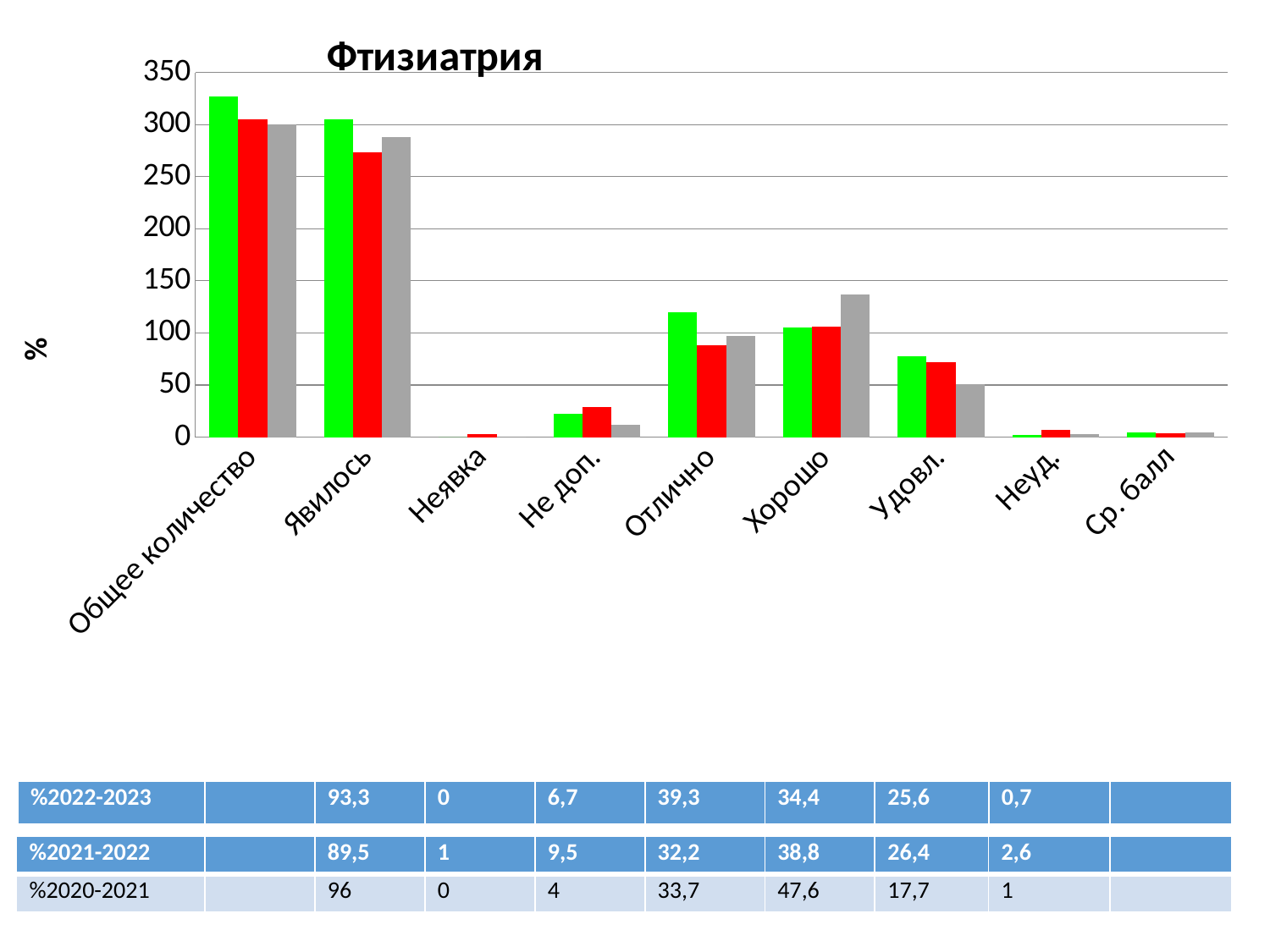
What kind of chart is shown on the slide? bar chart How many categories are shown on the x axis of the chart? 9 What label is shown on the vertical axis of the chart? % For the category Хорошо, which bar is taller: the gray bar or the green bar? the gray bar For the category Отлично, which bar is taller: the green bar or the gray bar? the green bar Is the value of the red bar for Отлично greater or less than 100? less Is the value of the green bar for Общее количество greater or less than 300? greater Is the value of the red bar for Явилось greater or less than 300? less What is the title of the chart? Фтизиатрия Which category has the tallest bar in the chart? Общее количество